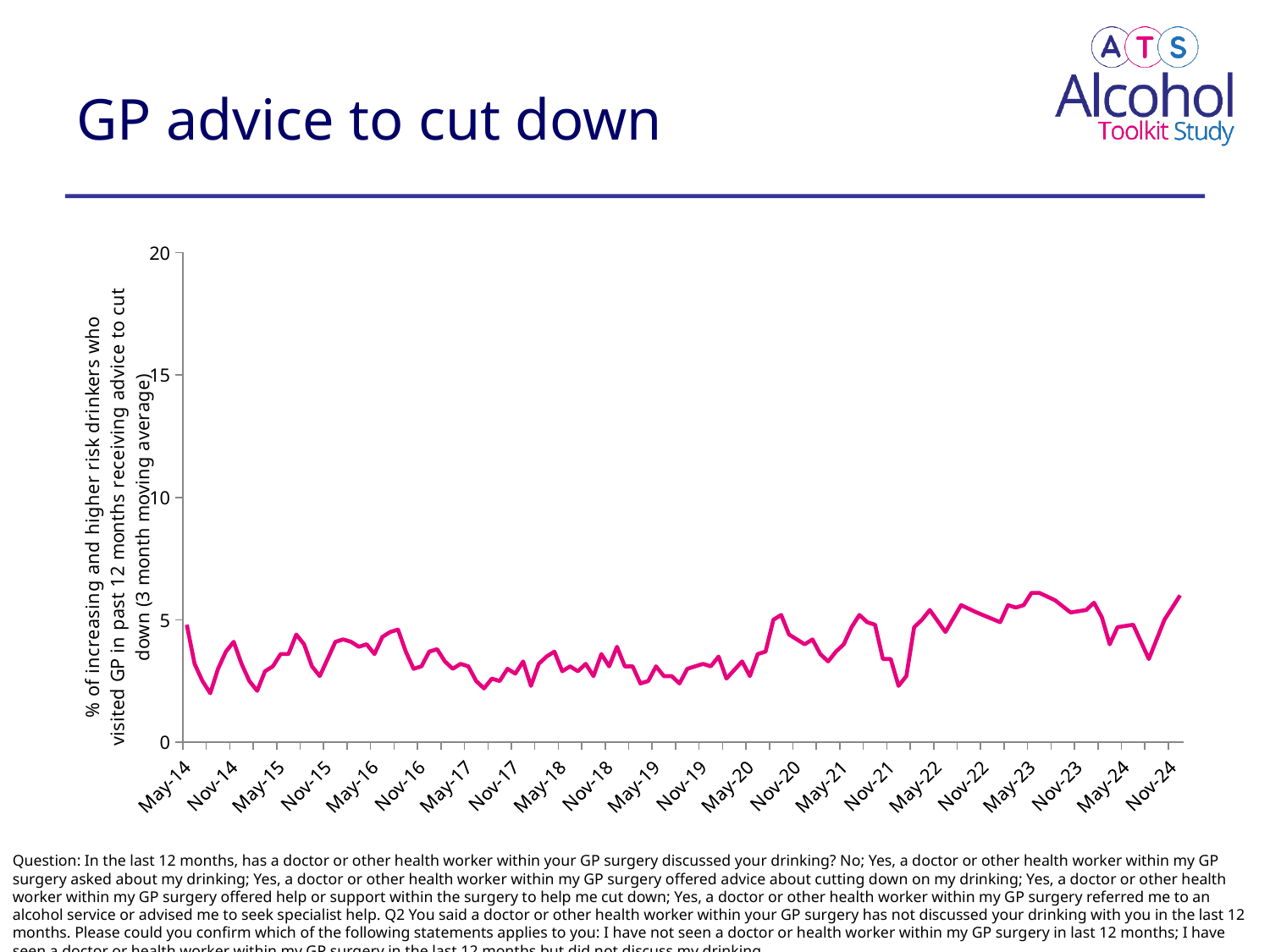
Which is larger, the value for May-23 or the value for Nov-17? May-23 What is the title of the chart on the slide? GP advice to cut down What kind of chart is shown on the slide? line chart Between Nov-21 and May-23, do the values generally rise or fall? rise How many lines are plotted in the chart? 1 Is the value for Nov-17 greater or less than 5? less Is the value for Nov-21 greater or less than 5? less What is the highest value shown on the y axis of the chart? 20 Is the value for May-23 greater or less than 5? greater What colour is the plotted line in the chart? pink How many date labels are shown along the x axis of the chart? 22